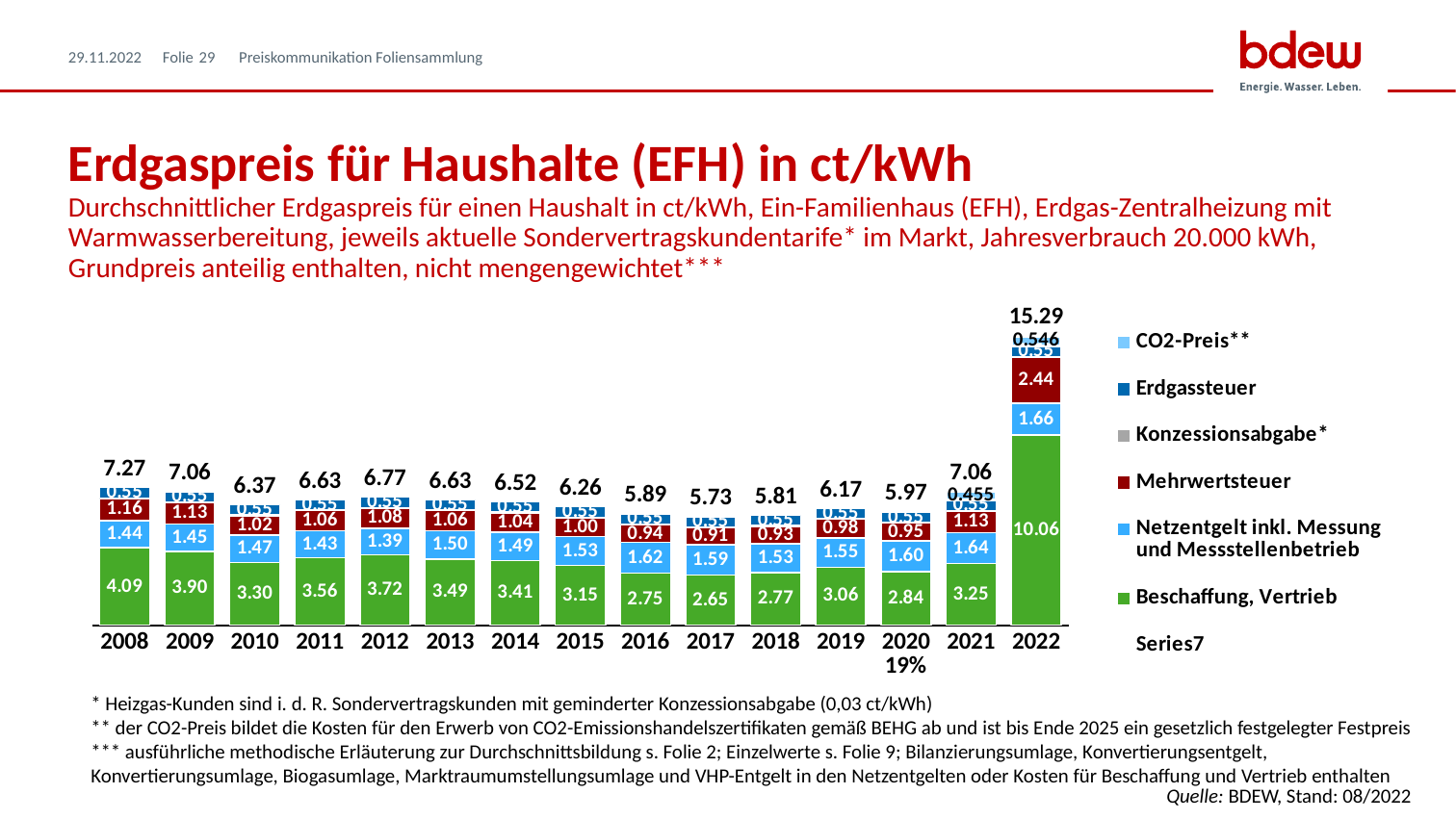
What is the Mehrwertsteuer value for 2022? 2.44 Which year has the highest total price? 2022 What is the title of the chart on the slide? Erdgaspreis für Haushalte (EFH) in ct/kWh What is the value of the Beschaffung, Vertrieb segment for 2022? 10.06 What is the Netzentgelt inkl. Messung und Messstellenbetrieb value for 2016? 1.62 How many entries does the legend list? 7 How many years are shown on the x axis? 15 Which is larger, the Beschaffung, Vertrieb value for 2008 or for 2009? 2008 What is the difference between the total price in 2022 and the total price in 2021? 8.23 Which year has the lowest total price? 2017 What kind of chart is shown on the slide? Stacked bar chart What is the total natural gas price shown above the bar for 2022? 15.29